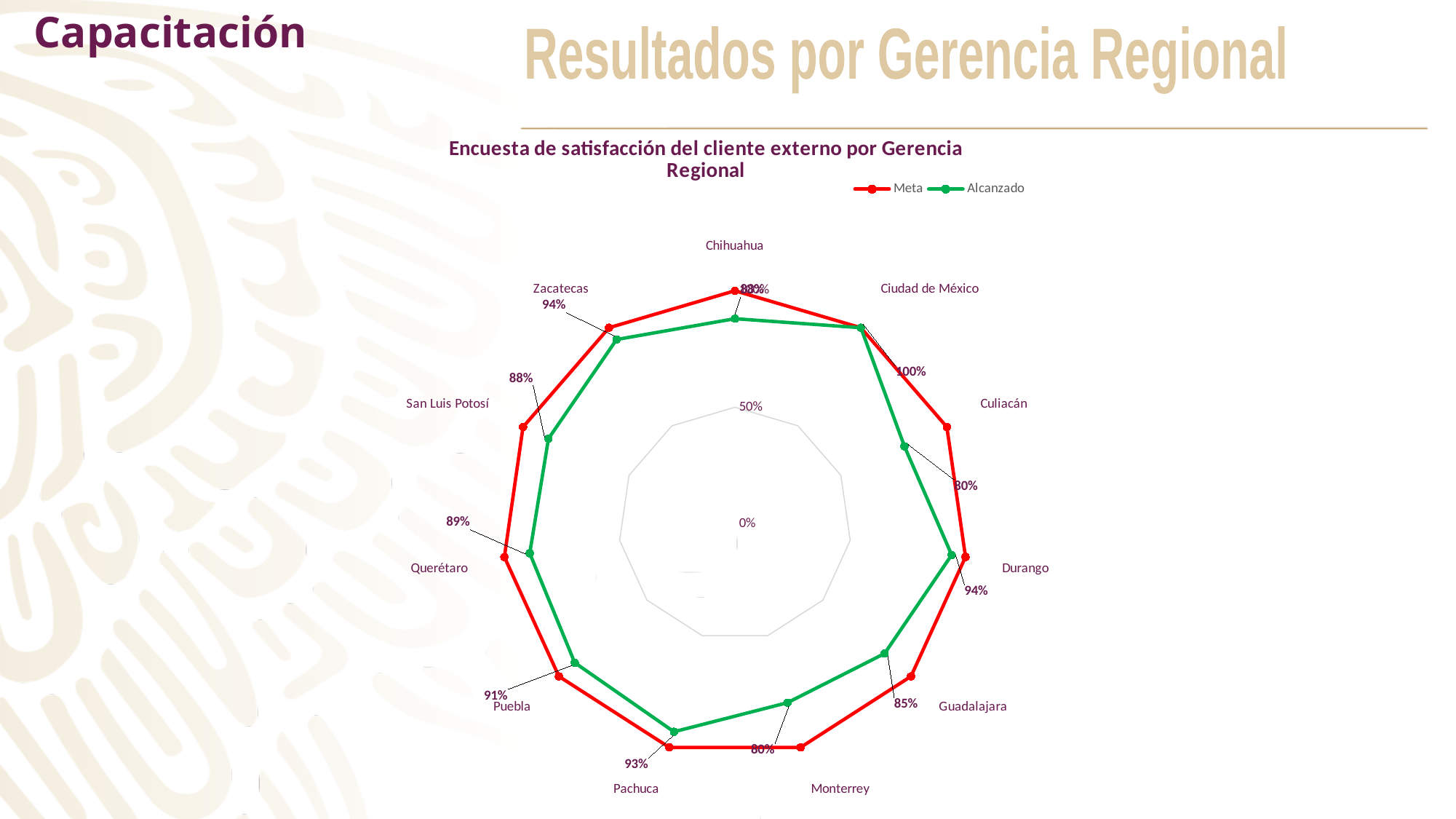
Which has a higher Alcanzado value, Pachuca or Monterrey? Pachuca What kind of chart is shown on the slide? Radar chart How many series does the legend list? 2 What is the Alcanzado value for Monterrey? 80% Which regional office has the highest Alcanzado value? Ciudad de México Which colour represents the Alcanzado series? Green How many regional offices (categories) are plotted on the radar chart? 11 What is the difference between the Alcanzado values for Durango and Guadalajara? 9 percentage points What is the Alcanzado value for San Luis Potosí? 88% What is the Alcanzado value for Ciudad de México? 100% For Querétaro, which series has the larger value, Meta or Alcanzado? Meta What is the Alcanzado value for Durango? 94%